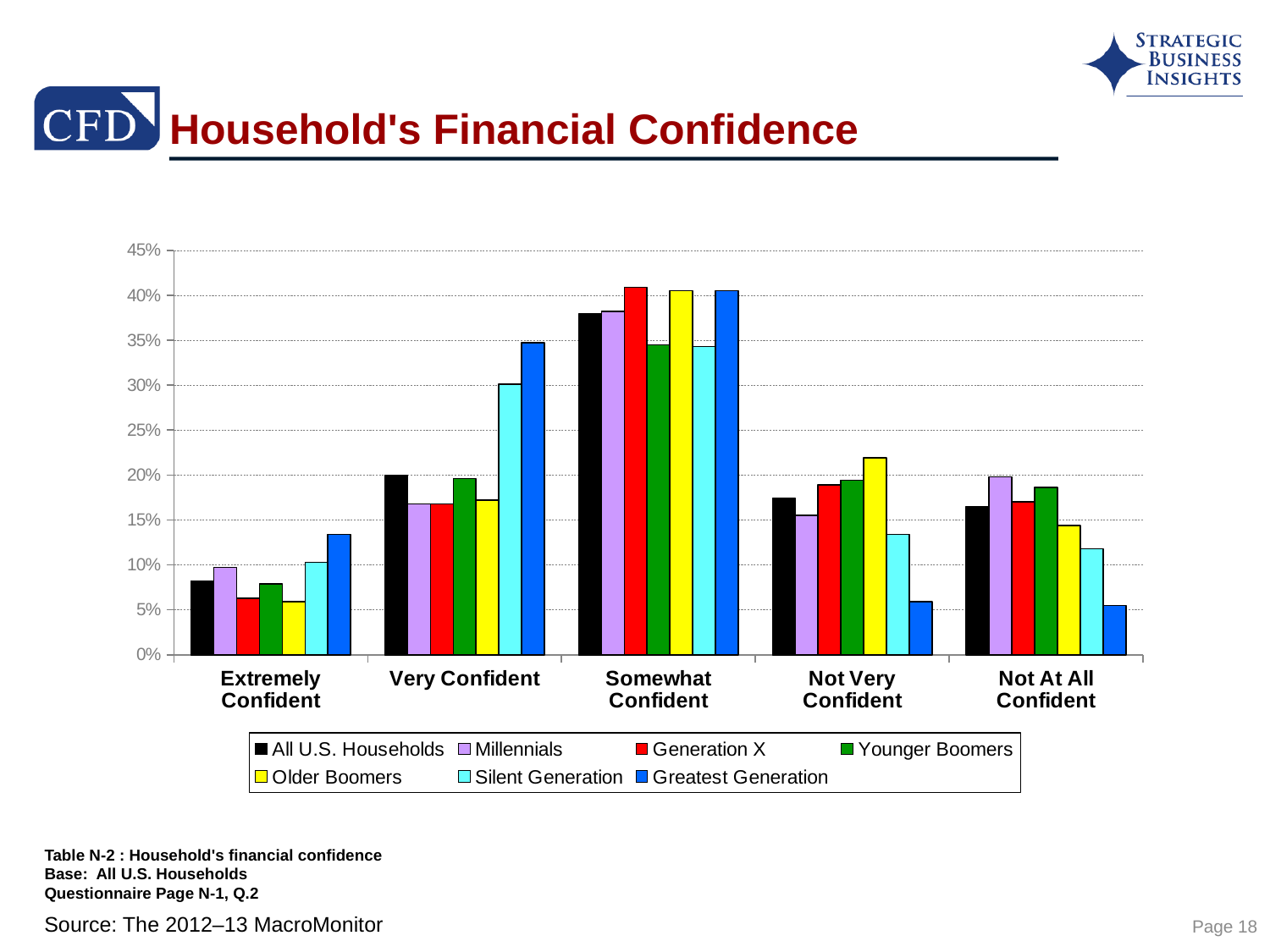
Which series has the highest value in the Extremely Confident category? Greatest Generation What colour represents Generation X in the legend? red Is the value for Greatest Generation in the Very Confident category greater or less than 30%? greater Is the value for Silent Generation in the Not At All Confident category greater or less than 15%? less In the Very Confident category, which is larger: Silent Generation or Millennials? Silent Generation Which series has the highest value in the Not Very Confident category? Older Boomers What kind of chart is shown on the slide? bar chart In the Not Very Confident category, which is larger: Older Boomers or Greatest Generation? Older Boomers Which series has the lowest value in the Not At All Confident category? Greatest Generation How many series does the legend list? 7 Is the value for All U.S. Households in the Somewhat Confident category greater or less than 35%? greater How many confidence categories are shown on the x axis? 5